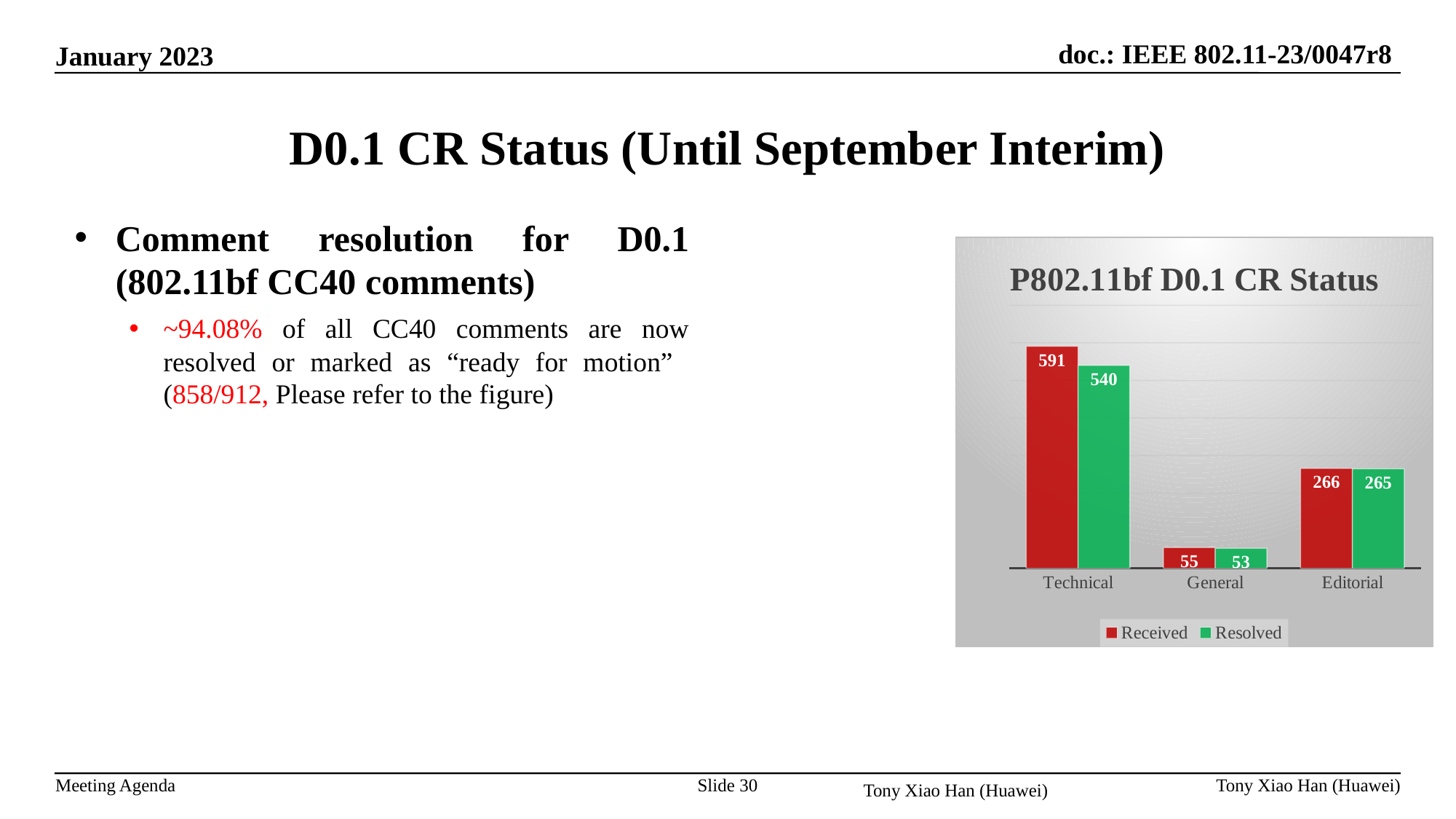
What is the difference between Received and Resolved for Technical? 51 How many series does the legend list? 2 Which category has the highest Received value? Technical What is the title of the chart? P802.11bf D0.1 CR Status How many categories are shown on the x axis? 3 What is the Resolved value for General? 53 Which is larger, the Received value for Editorial or the Received value for General? Editorial What is the Received value for Technical? 591 What kind of chart is shown? bar chart What is the difference between Received and Resolved for Editorial? 1 What is the Resolved value for Editorial? 265 Which category has the lowest Resolved value? General